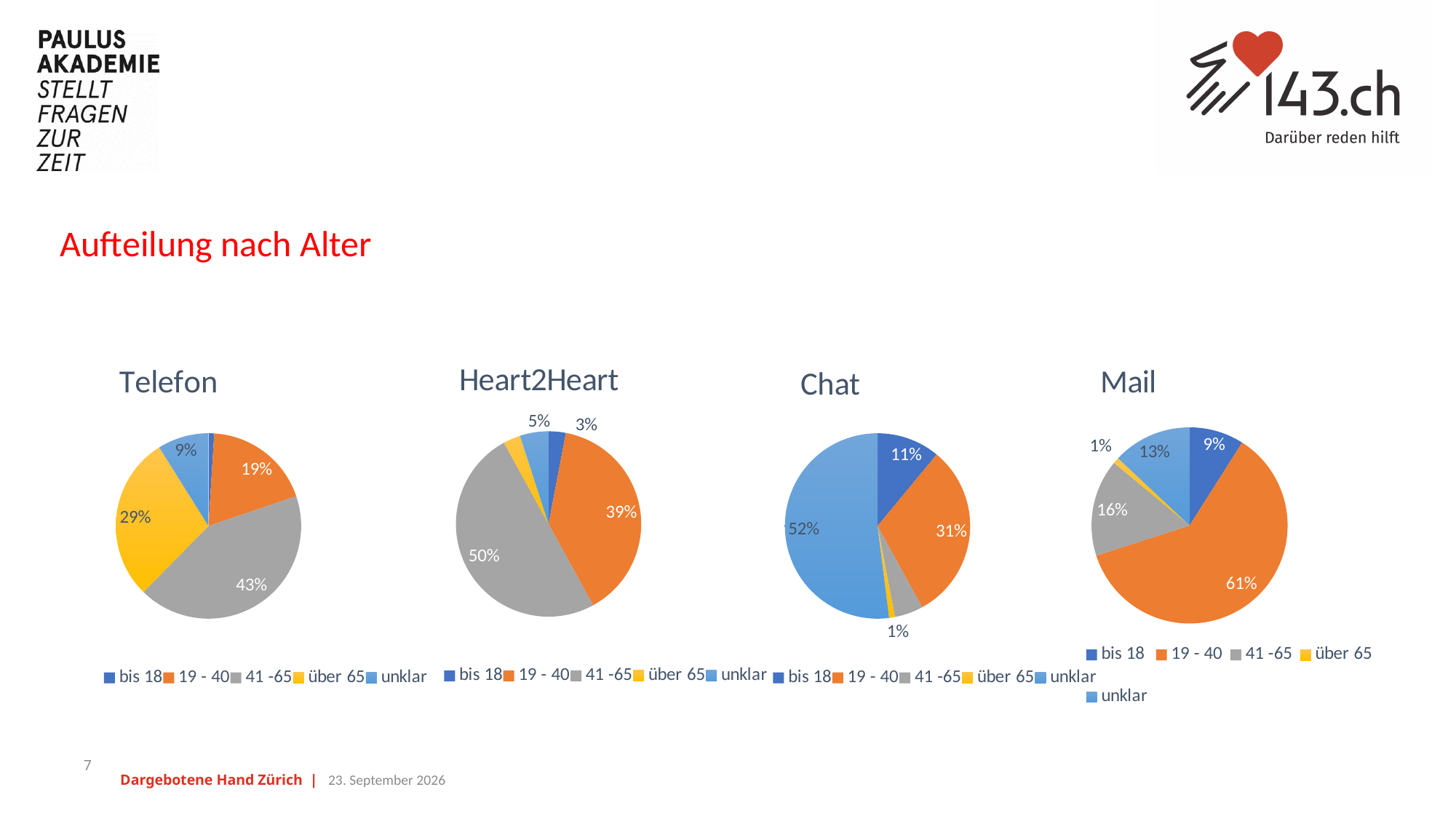
In the Heart2Heart chart, which age group has the largest slice? 41 -65 How many pie charts are shown on the slide? 4 How many entries does the legend of the Chat chart list? 5 In the Mail chart, which is larger, the unklar slice or the bis 18 slice? unklar In the Chat chart, what is the difference between the 19 - 40 share and the bis 18 share? 20% In the Telefon chart, what share is labelled for the 41 -65 slice? 43% In the Chat chart, what percentage is labelled for unklar? 52% In the Telefon chart, what percentage is shown for über 65? 29% In the Heart2Heart chart, what share is shown for the 19 - 40 slice? 39% In the Mail chart, what share is shown for 41 -65? 16% In the Mail chart, which age group has the largest slice? 19 - 40 What kind of chart is used for the Telefon data? pie chart